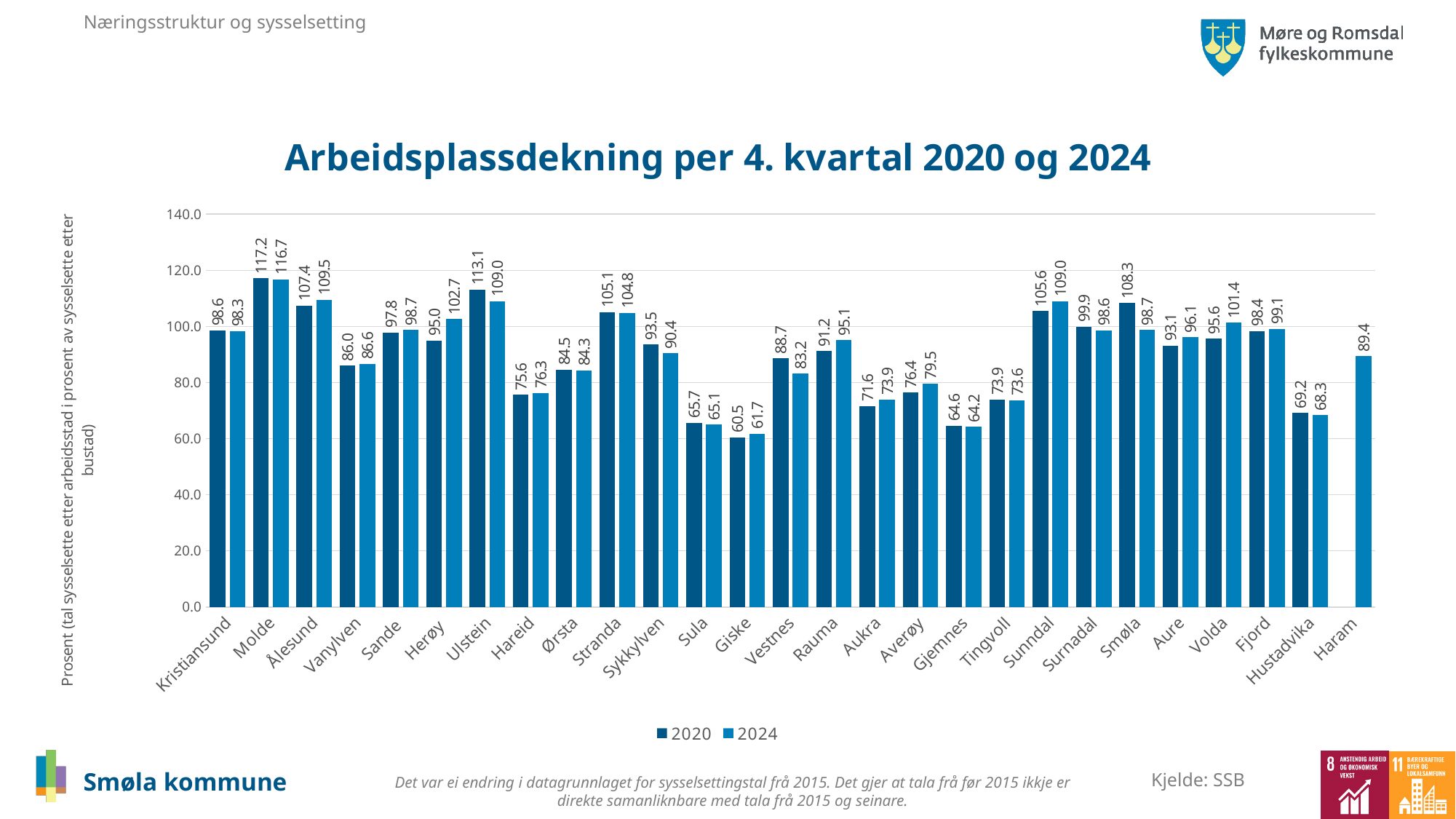
By how much did Herøy's value increase from 2020 to 2024? 7.7 What is the difference between the 2020 and 2024 values for Smøla? 9.6 How many municipalities are shown on the x axis? 27 What is the 2024 value for Haram? 89.4 How many series does the legend list? 2 What kind of chart is shown on the slide? Bar chart Which is larger for Ulstein: the 2020 value or the 2024 value? 2020 Which municipality has the highest 2020 value? Molde Which municipality has the lowest 2024 value? Giske What is the 2020 value for Smøla? 108.3 What is the 2024 value for Herøy? 102.7 Is the 2024 value for Sunndal greater or less than 100? greater